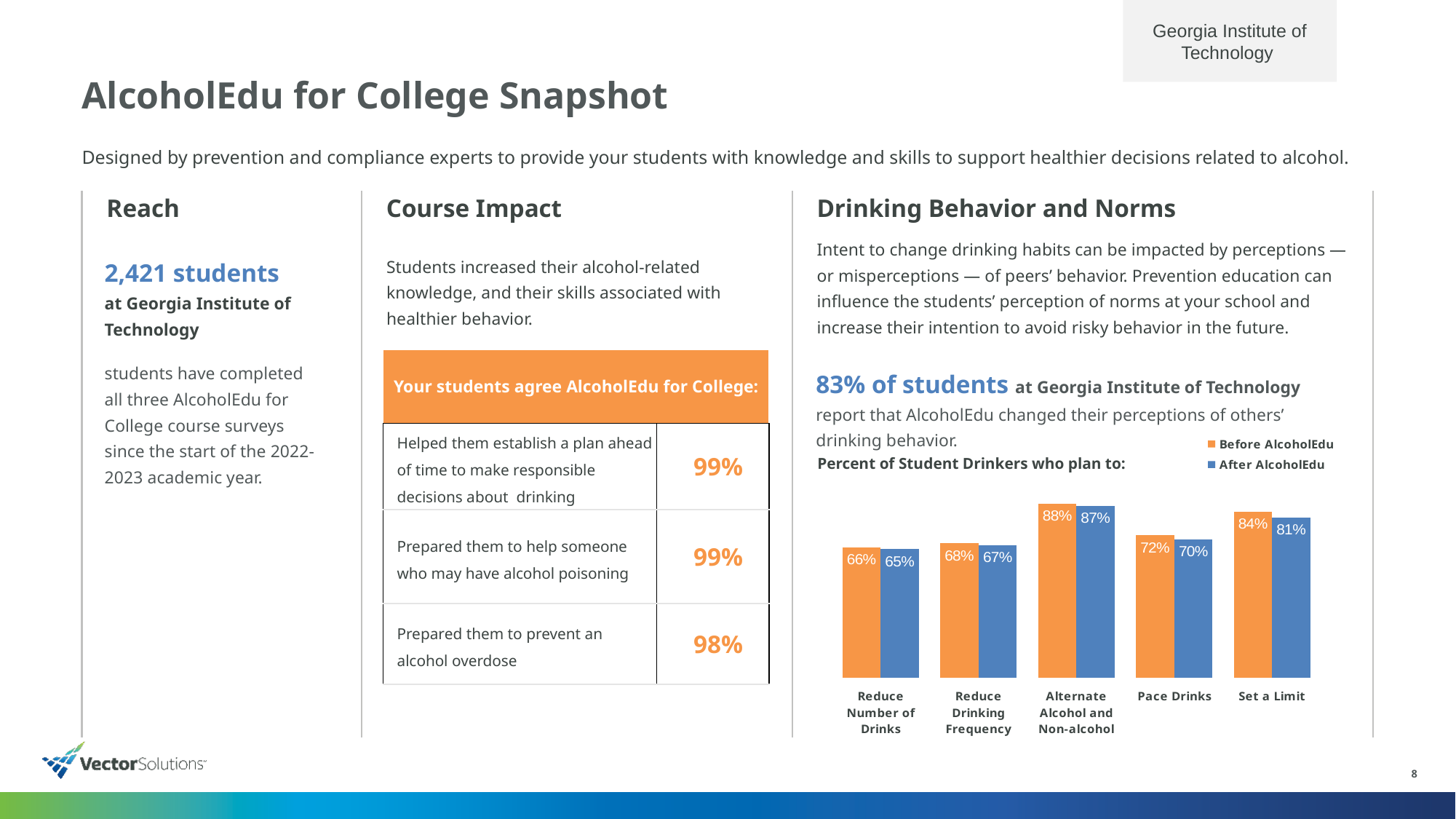
Which category has the lowest After AlcoholEdu value? Reduce Number of Drinks What is the difference between the Before AlcoholEdu and After AlcoholEdu values for Set a Limit? 3% What is the After AlcoholEdu value for Pace Drinks? 70% What is the Before AlcoholEdu value for Reduce Drinking Frequency? 68% Which is larger for Pace Drinks: the Before AlcoholEdu value or the After AlcoholEdu value? Before AlcoholEdu What kind of chart is shown on the slide? Bar chart Which category has the highest Before AlcoholEdu value? Alternate Alcohol and Non-alcohol What is the Before AlcoholEdu value for Reduce Number of Drinks? 66% What colour represents the After AlcoholEdu series in the chart? Blue How many categories are shown on the x axis of the chart? 5 What is the After AlcoholEdu value for Set a Limit? 81% How many series does the chart legend list? 2